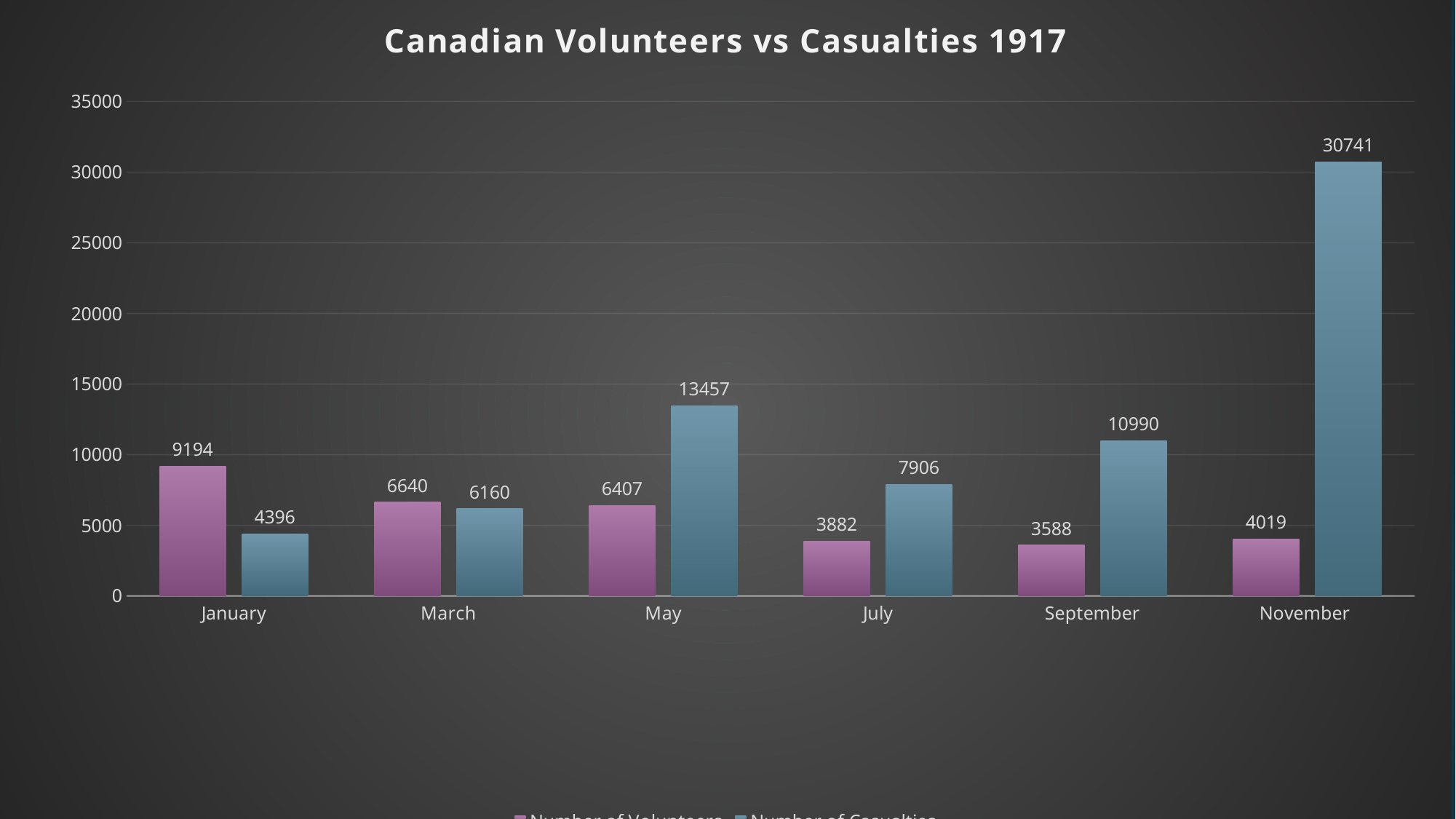
What type of chart is shown on the slide? bar chart Is the Number of Casualties for July greater or less than 10000? less How many series does the chart's legend list? 2 What is the Number of Casualties for November? 30741 What is the difference between the Number of Casualties and the Number of Volunteers in September? 7402 Which month has the highest Number of Casualties? November What is the Number of Casualties for May? 13457 Which month has the lowest Number of Volunteers? September In January, which is larger: the Number of Volunteers or the Number of Casualties? Number of Volunteers What is the Number of Volunteers for January? 9194 What is the title of the chart? Canadian Volunteers vs Casualties 1917 How many months are shown on the x axis of the chart? 6